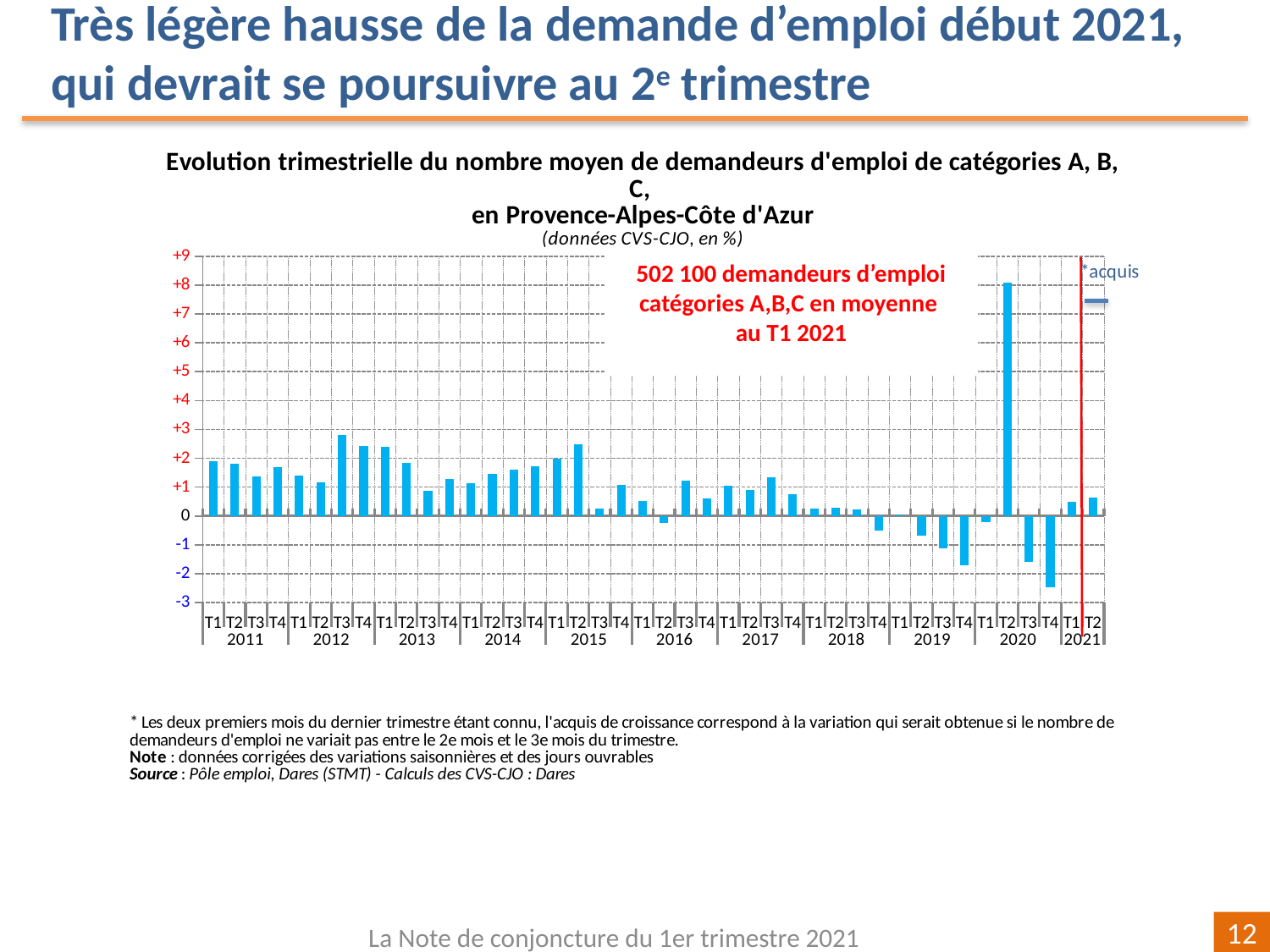
Is the value for T4 2020 greater or less than -2? less Which is larger, the value for T1 2019 or the value for T2 2019? T1 2019 Is the value for T1 2021 greater or less than +1? less Do the values rise or fall across the four quarters of 2019, from T1 to T4? fall Which is larger, the value for T3 2012 or the value for T1 2011? T3 2012 Is the value for T2 2020 greater or less than +5? greater How many years are labelled on the x axis of the chart? 11 What kind of chart is shown on the slide? bar chart Which quarter has the lowest value in the chart? T4 2020 Which quarter has the highest value in the chart? T2 2020